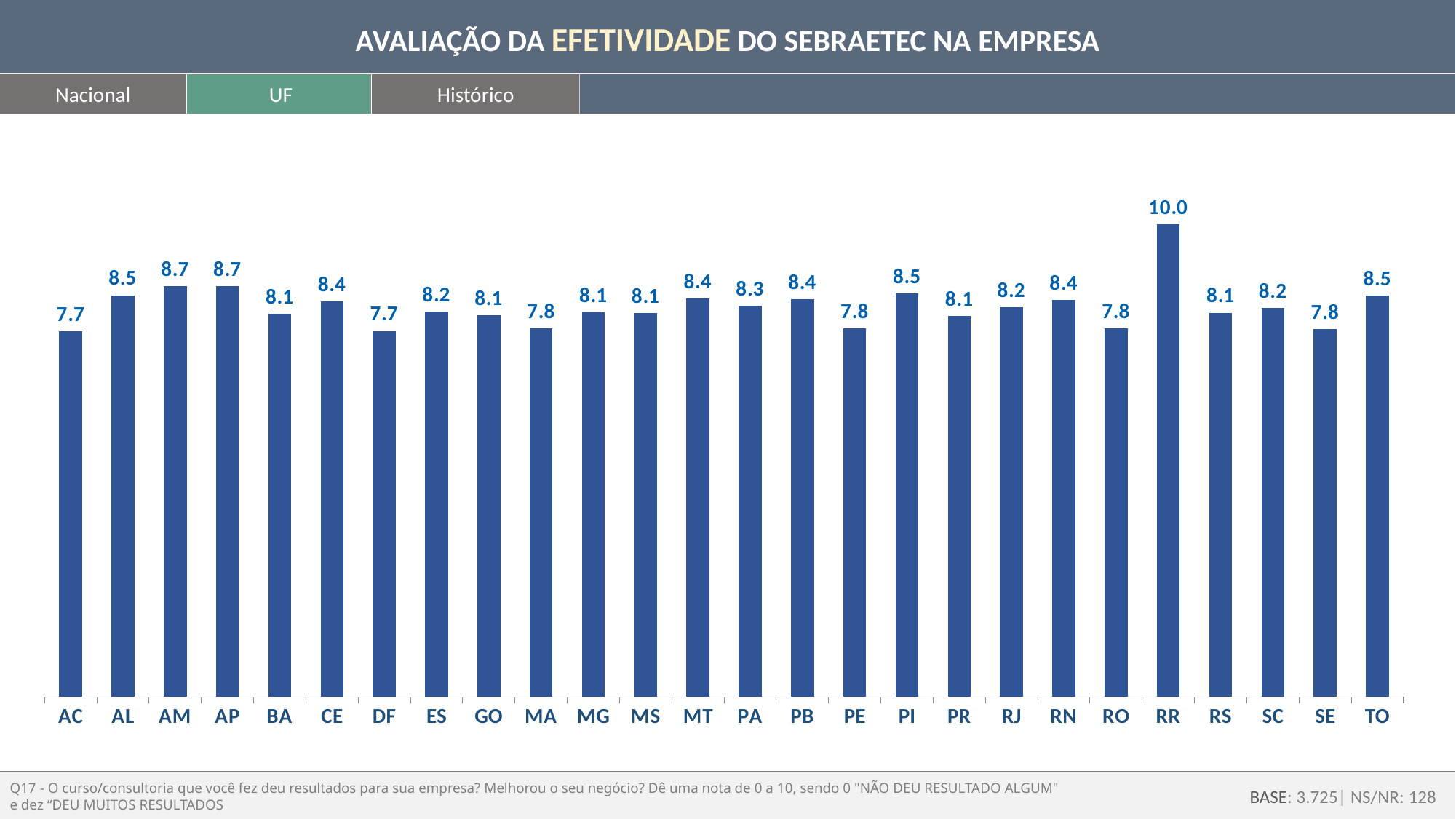
What is the difference between the values for RR and AM? 1.3 How many states are shown on the chart? 26 What is the value for AC? 7.7 What is the value for RR? 10.0 Which is larger, the value for CE or the value for MA? CE What is the lowest value shown on the chart? 7.7 What is the difference between the values for PI and PE? 0.7 What kind of chart is shown on the slide? Bar chart Which state has the highest value? RR What is the title of the slide? AVALIAÇÃO DA EFETIVIDADE DO SEBRAETEC NA EMPRESA What is the value for TO? 8.5 What is the value for PA? 8.3